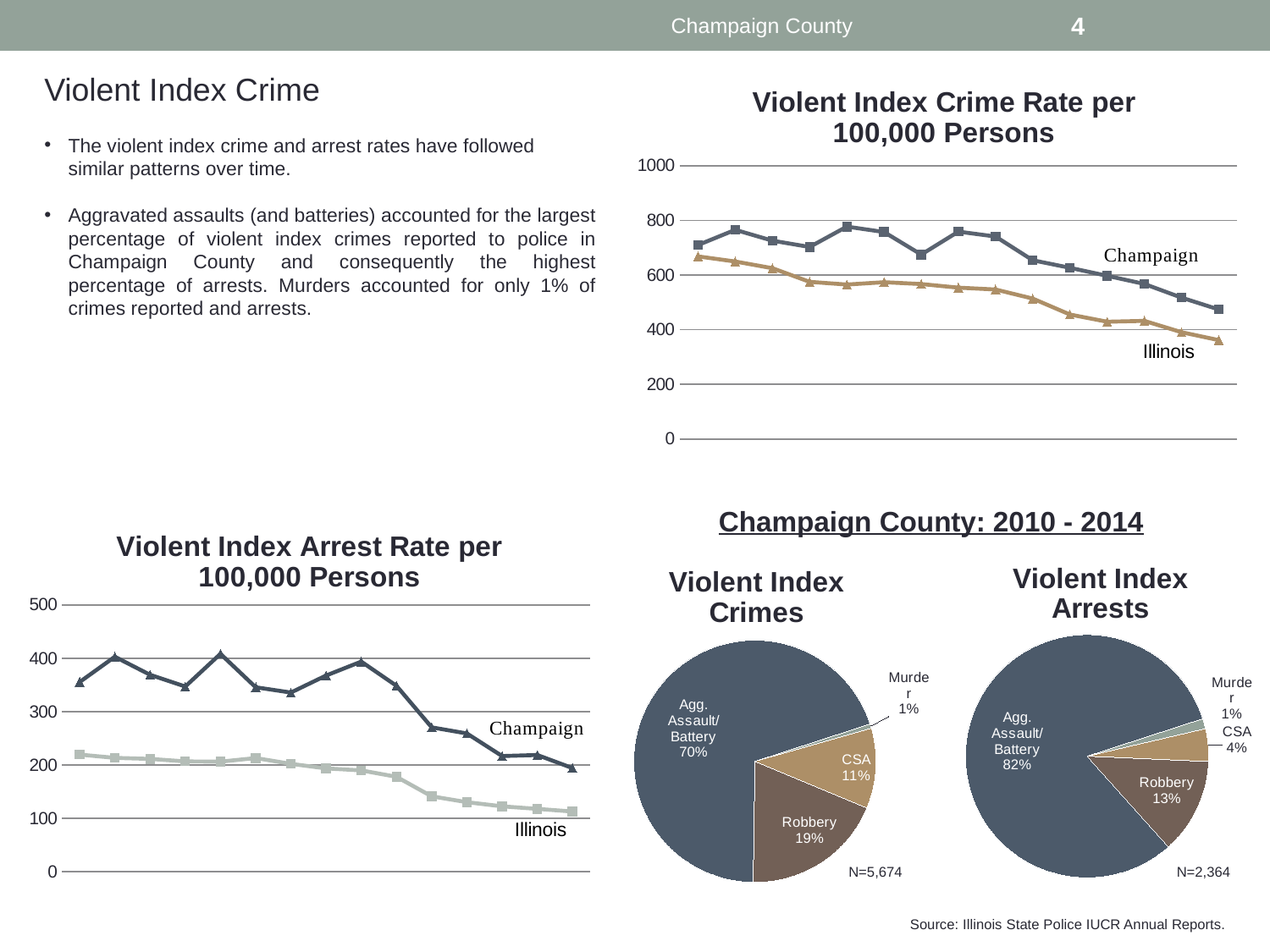
What kind of chart is the "Violent Index Crime Rate per 100,000 Persons" chart? line chart In the "Violent Index Crime Rate per 100,000 Persons" chart, is the last Illinois value greater or less than 400? less In the "Violent Index Crime Rate per 100,000 Persons" chart, does the Illinois line rise or fall from left to right? fall In the "Violent Index Arrest Rate per 100,000 Persons" chart, is the last Illinois value greater or less than 200? less In the "Violent Index Crimes" pie chart, which category has the smallest slice? Murder In the "Violent Index Arrests" pie chart, what share is Robbery? 13% How many percentage points higher is the Robbery share in the "Violent Index Crimes" pie chart than in the "Violent Index Arrests" pie chart? 6 In the "Violent Index Crime Rate per 100,000 Persons" chart, is the first Champaign value greater or less than 600? greater What is the N value shown for the "Violent Index Arrests" pie chart? N=2,364 In the "Violent Index Arrest Rate per 100,000 Persons" chart, which series has the higher values, Champaign or Illinois? Champaign In the "Violent Index Arrests" pie chart, which category has the largest slice? Agg. Assault/Battery In the "Violent Index Crimes" pie chart, what share is Agg. Assault/Battery? 70%